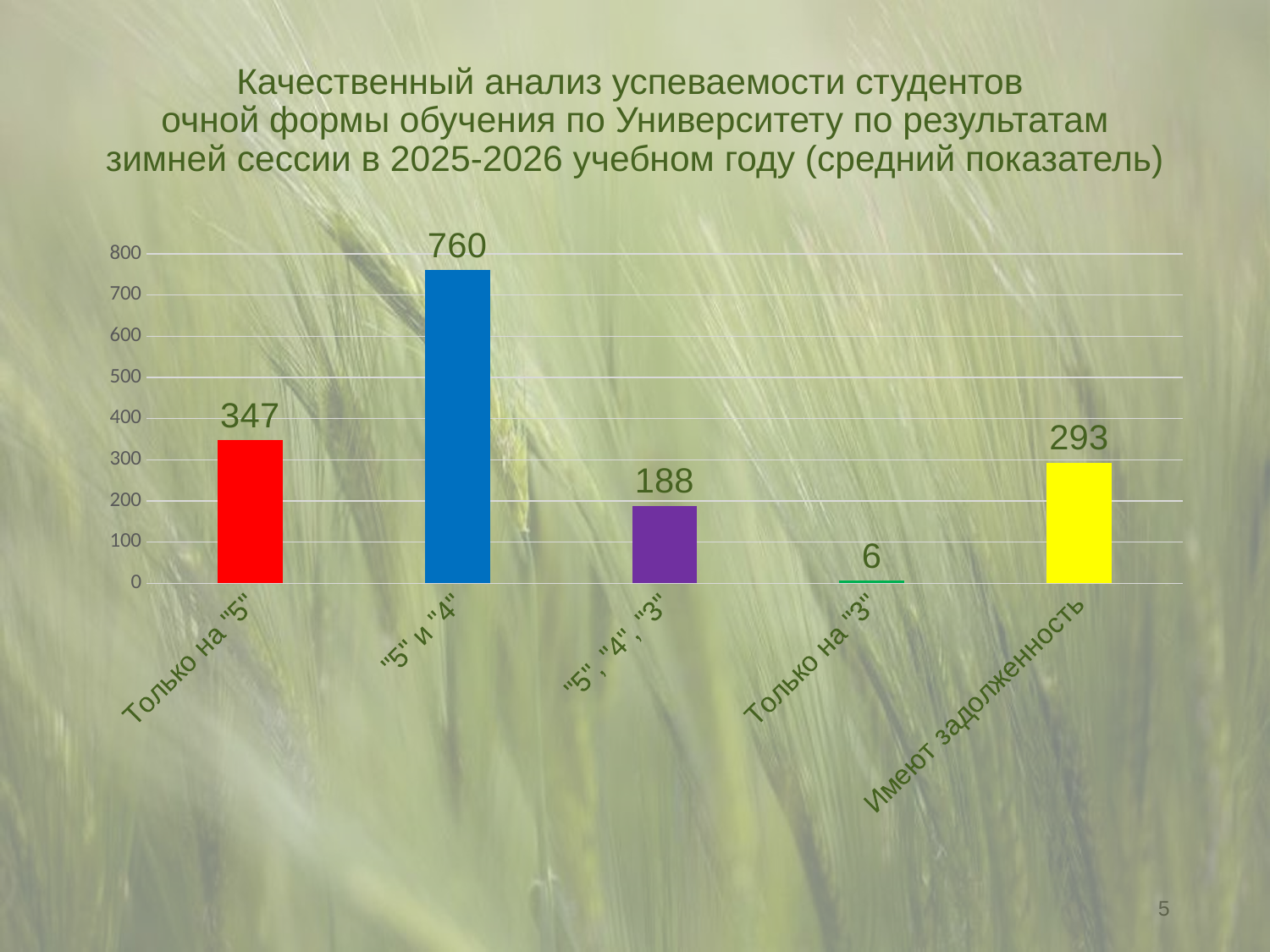
What is the value for the category Только на "5"? 347 What is the difference between the values for "5" и "4" and Только на "5"? 413 What is the value for the category Только на "3"? 6 How many categories are shown on the chart? 5 What kind of chart is shown on the slide? bar chart Which is larger: the value for Только на "5" or the value for Имеют задолженность? Только на "5" Is the value for "5", "4", "3" greater or less than 200? less Which category has the highest value? "5" и "4" Which category has the lowest value? Только на "3" What colour is the bar for Имеют задолженность? yellow What is the value for the category "5" и "4"? 760 What is the value for the category Имеют задолженность? 293